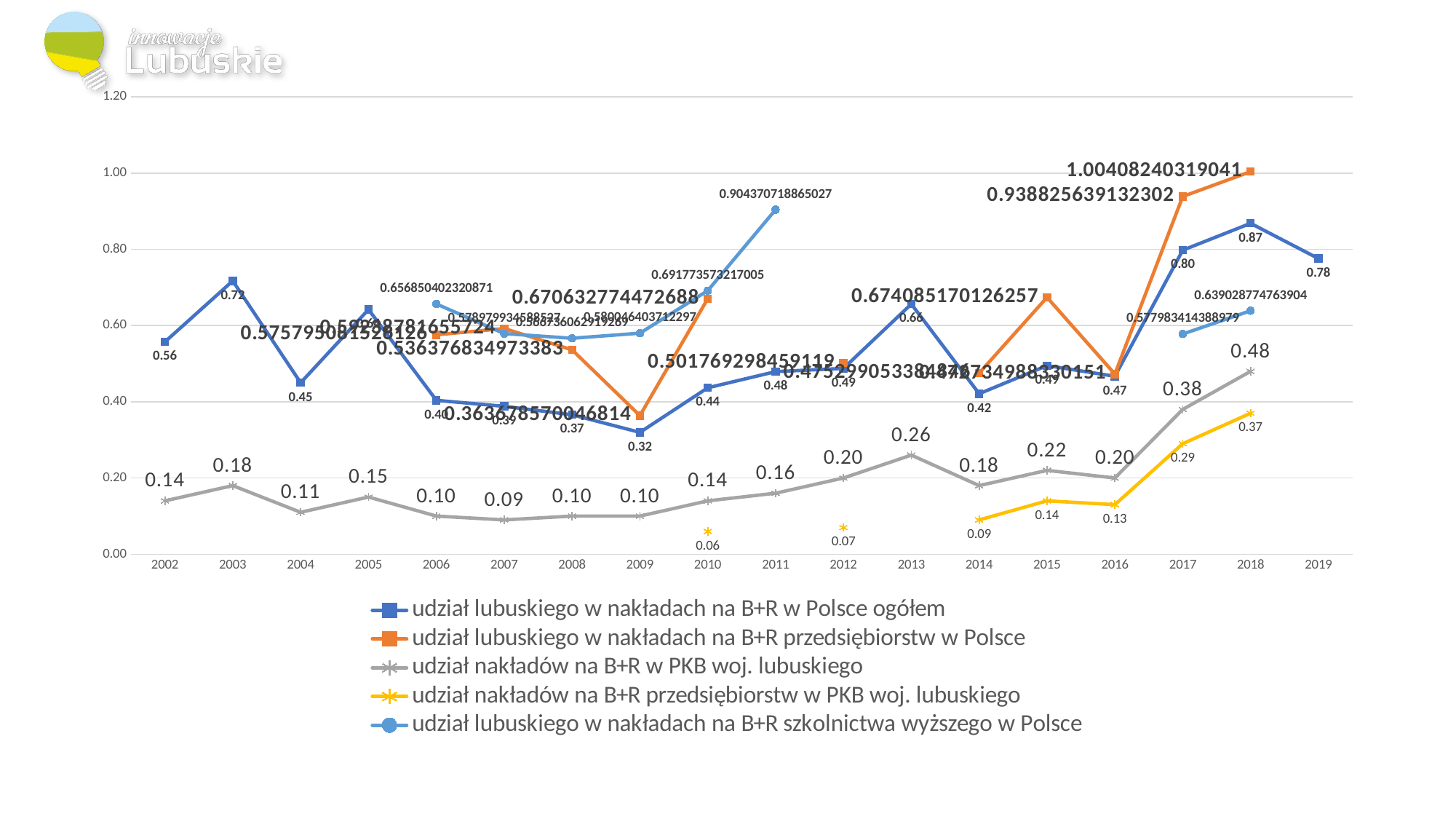
What is the value of 'udział lubuskiego w nakładach na B+R w Polsce ogółem' in 2003? 0.72 Is the value of 'udział lubuskiego w nakładach na B+R przedsiębiorstw w Polsce' in 2017 greater or less than 0.80? greater What is the value of 'udział lubuskiego w nakładach na B+R przedsiębiorstw w Polsce' in 2018? 1.00408240319041 What is the value of 'udział nakładów na B+R w PKB woj. lubuskiego' in 2013? 0.26 What is the value of 'udział lubuskiego w nakładach na B+R szkolnictwa wyższego w Polsce' in 2011? 0.904370718865027 How many series does the legend list? 5 In which year is 'udział lubuskiego w nakładach na B+R w Polsce ogółem' highest? 2018 What is the value of 'udział nakładów na B+R przedsiębiorstw w PKB woj. lubuskiego' in 2018? 0.37 What kind of chart is shown on the slide? line chart How many years are shown on the x axis? 18 By how much did 'udział nakładów na B+R w PKB woj. lubuskiego' increase from 2017 to 2018? 0.10 In which year is 'udział lubuskiego w nakładach na B+R w Polsce ogółem' lowest? 2009